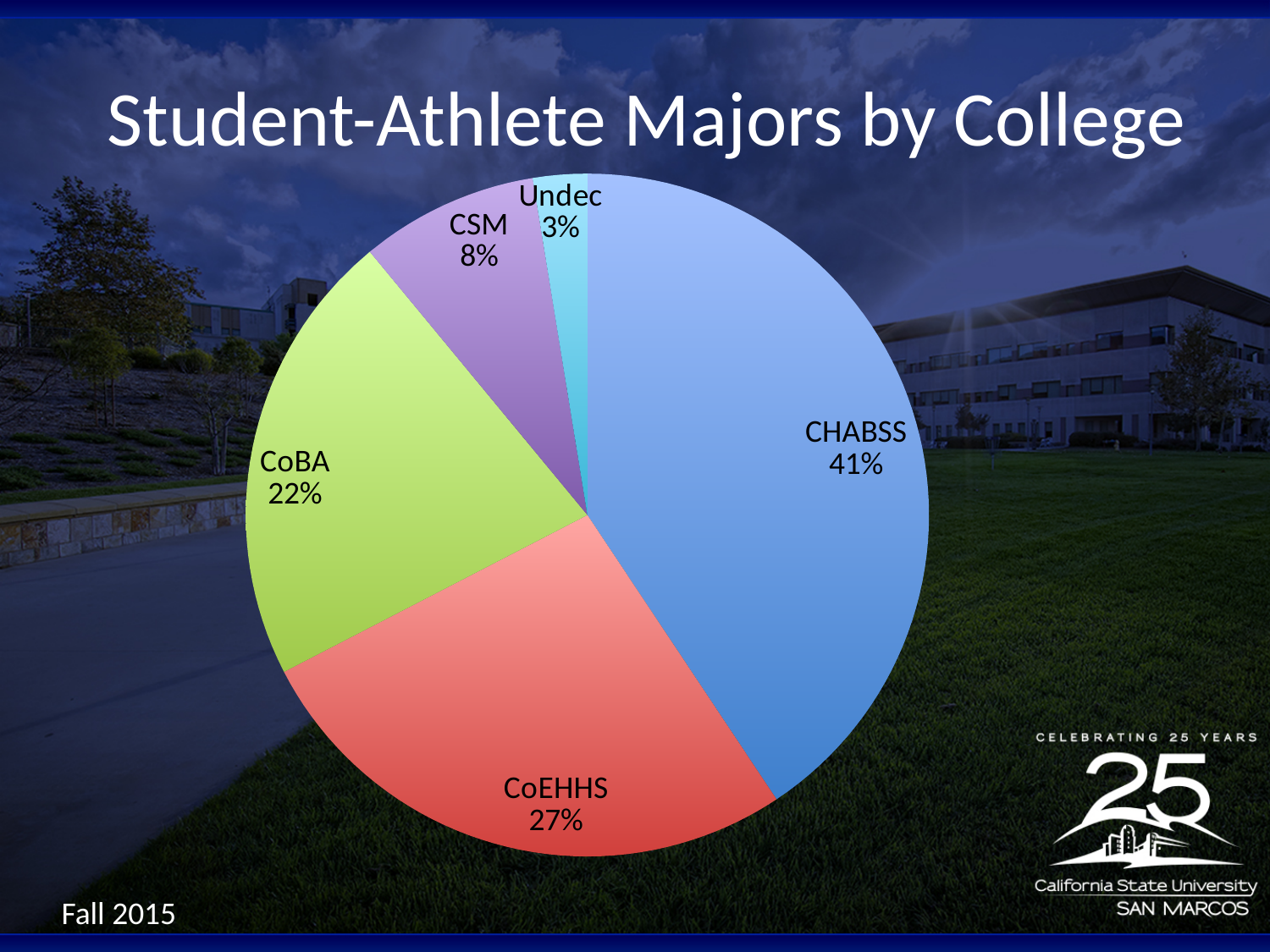
What share of student-athlete majors is in CoEHHS? 27% Which slice of the pie is the smallest? Undec How many slices does the pie chart have? 5 Which is larger, the CoBA share or the CSM share? CoBA What kind of chart is shown on the slide? Pie chart What share of student-athlete majors is in CHABSS? 41% Which college has the largest share of student-athlete majors? CHABSS What is the difference in percentage points between the CHABSS and CoEHHS shares? 14 What is the title of the chart on the slide? Student-Athlete Majors by College What share of student-athlete majors is Undec? 3% What share of student-athlete majors is in CoBA? 22% What share of student-athlete majors is in CSM? 8%